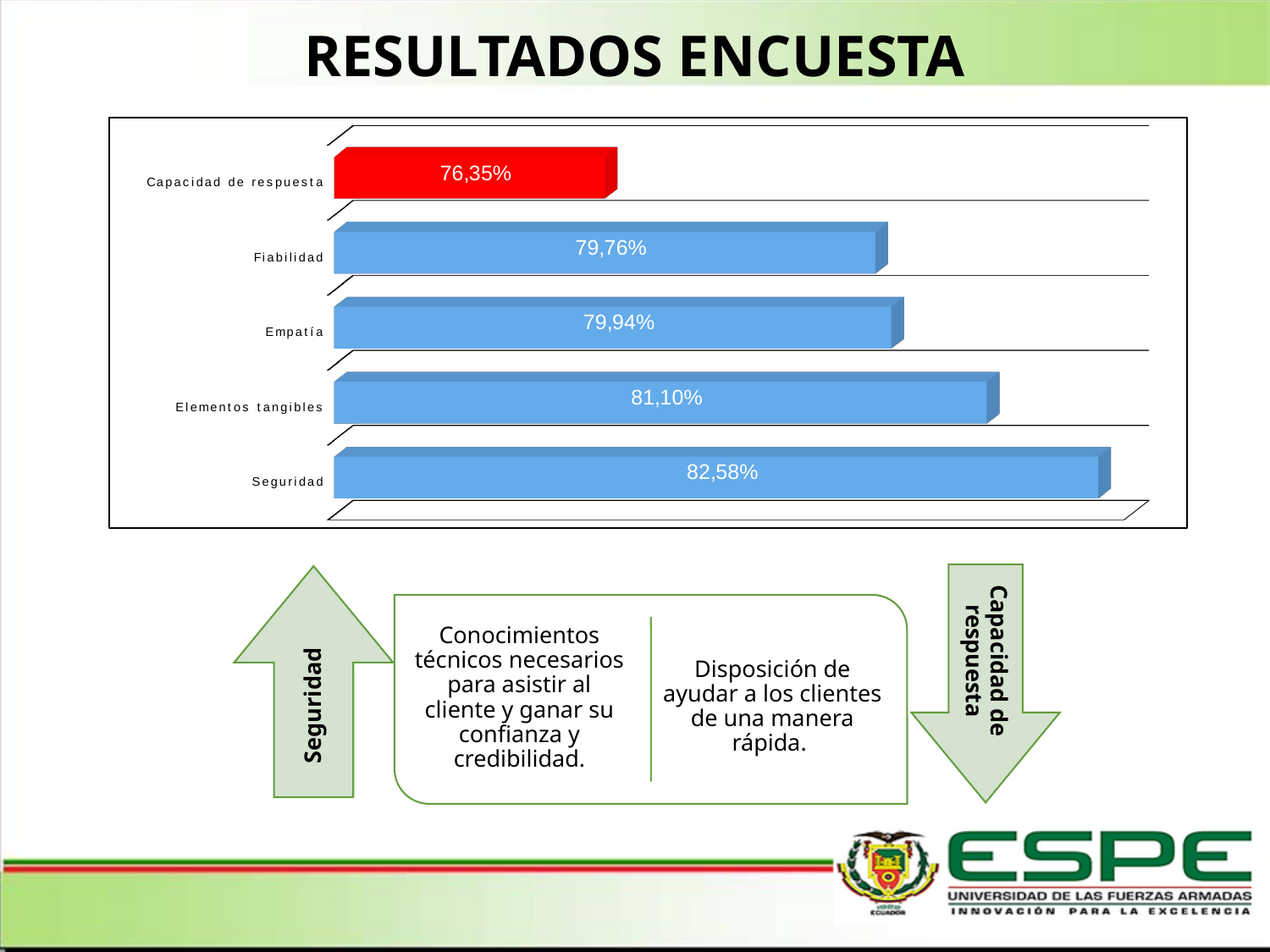
What is the value for Seguridad? 82,58% Which category has the lowest value? Capacidad de respuesta What is the value for Capacidad de respuesta? 76,35% What is the value for Empatía? 79,94% How many categories are shown in the chart? 5 What kind of chart is shown on the slide? Bar chart Which is larger, the value for Elementos tangibles or the value for Capacidad de respuesta? Elementos tangibles Which category has the highest value? Seguridad What is the value for Fiabilidad? 79,76% What is the difference between the values for Seguridad and Capacidad de respuesta? 6,23 percentage points What is the difference between the values for Elementos tangibles and Fiabilidad? 1,34 percentage points What is the value for Elementos tangibles? 81,10%